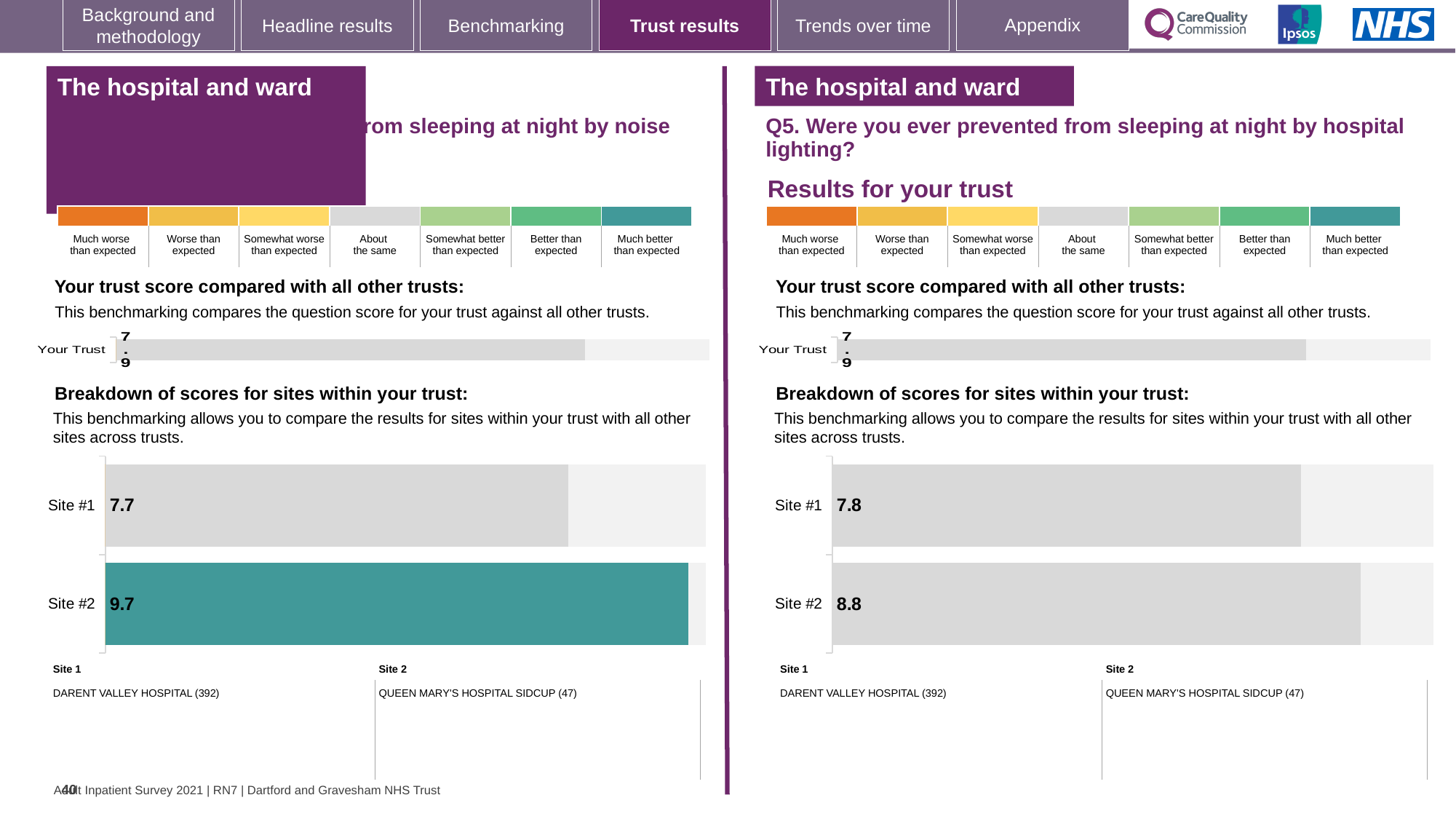
What type of chart is used for the breakdown of scores for sites within your trust on the right-hand slide section? Bar chart How many sites are shown in the right-hand site breakdown chart (Q5, hospital lighting)? 2 On the left-hand slide section (sleeping at night by noise), what is the score for Site #2 in the breakdown of scores for sites within your trust? 9.7 On the right-hand slide section (Q5, hospital lighting), which site has the lower score in the site breakdown chart? Site #1 On the right-hand slide section (Q5, hospital lighting), what is the score for Site #1 in the breakdown of scores for sites within your trust? 7.8 On the left-hand slide section (sleeping at night by noise), what is the score for Site #1 in the breakdown of scores for sites within your trust? 7.7 Is the Site #2 score in the left-hand site breakdown chart (sleeping at night by noise) larger or smaller than the Site #2 score in the right-hand site breakdown chart (hospital lighting)? larger On the right-hand slide section (Q5, hospital lighting), what is the score shown for Your Trust in the trust score chart? 7.9 On the right-hand slide section (Q5, hospital lighting), what is the difference between the Site #2 and Site #1 scores? 1.0 On the left-hand slide section (sleeping at night by noise), what is the difference between the Site #2 and Site #1 scores? 2.0 On the left-hand slide section (sleeping at night by noise), which site has the higher score in the site breakdown chart? Site #2 On the right-hand slide section (Q5, hospital lighting), what is the score for Site #2 in the breakdown of scores for sites within your trust? 8.8